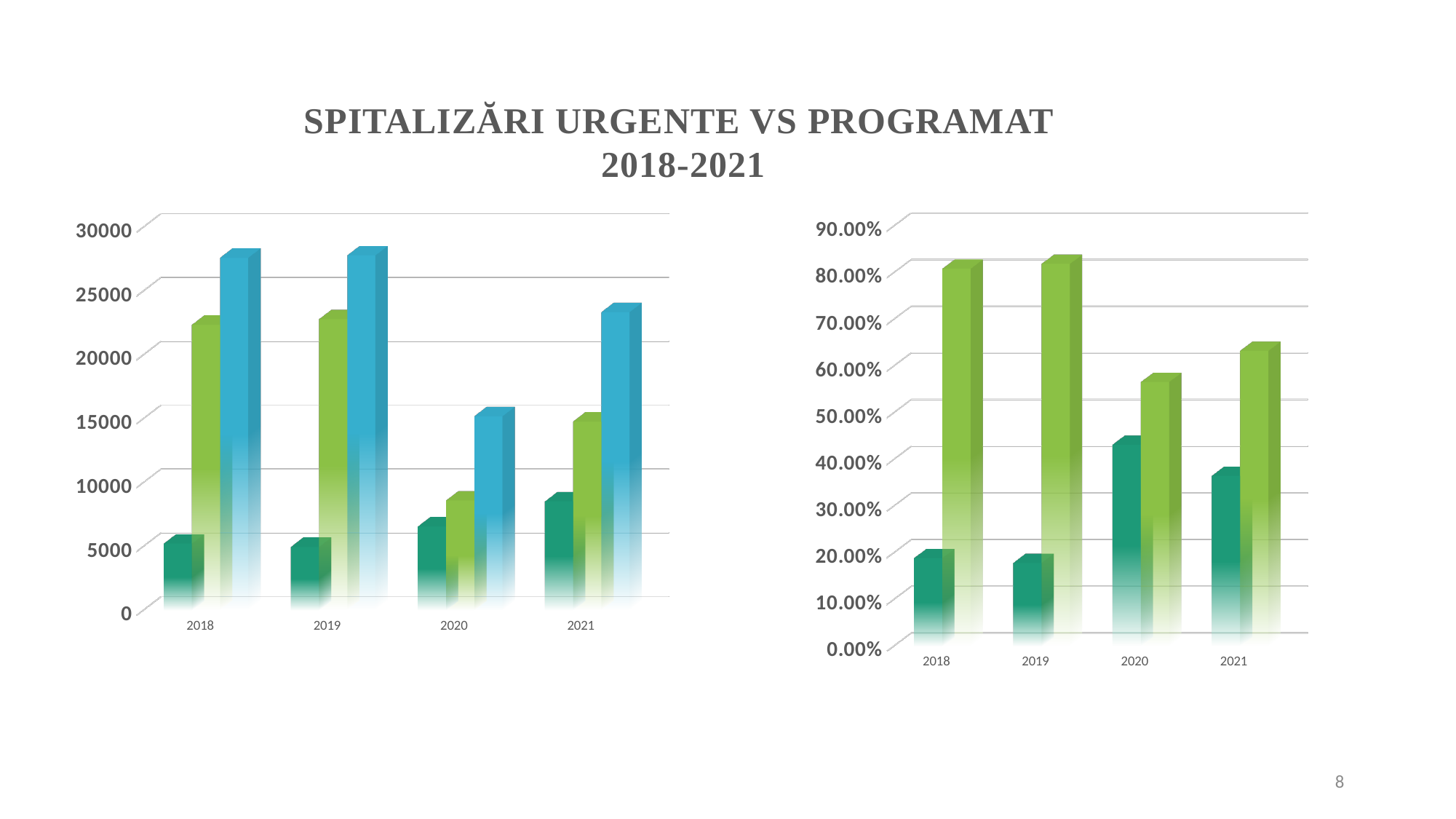
In the left chart, is the value of the blue bar for 2018 greater or less than 25000? greater What is the title of the slide? SPITALIZĂRI URGENTE VS PROGRAMAT 2018-2021 What kind of chart is the left chart? bar chart How many years are shown on the x axis of the left chart? 4 In the right chart, is the value of the dark green bar for 2018 greater or less than 30.00%? less In the left chart, is the value of the blue bar for 2020 greater or less than 20000? less What kind of chart is the right chart? bar chart How many bars are shown for each year in the right chart? 2 In the right chart, which year has the lowest light green bar? 2020 In the left chart for 2020, which is larger, the light green bar or the blue bar? the blue bar How many bars are shown for each year in the left chart? 3 In the left chart, which year has the shortest blue bar? 2020